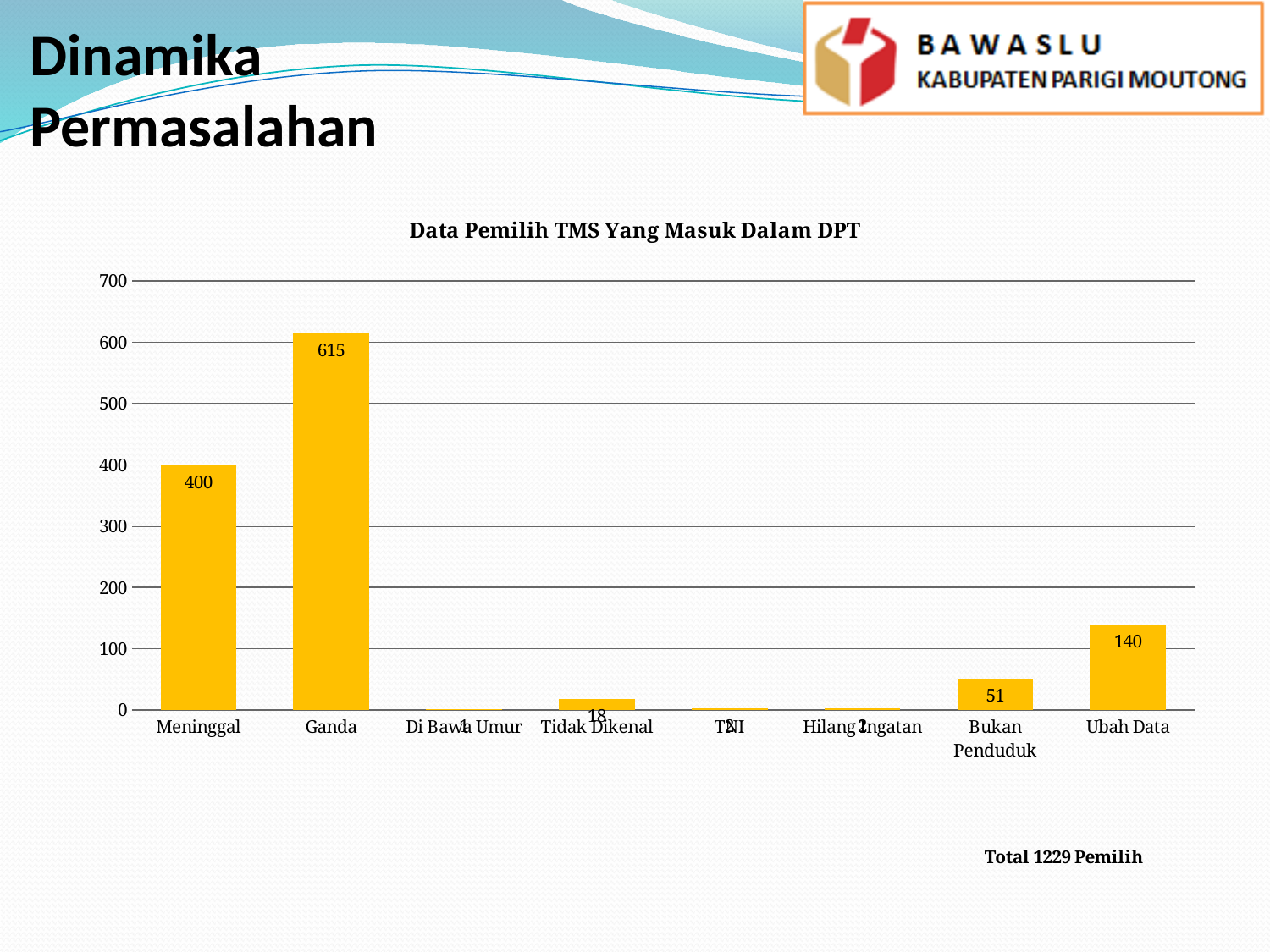
What is the value for Ubah Data in the chart? 140 Is the value for Ubah Data greater or less than 200? less How many categories are shown on the x axis of the chart? 8 Which is larger, the value for Ubah Data or the value for Bukan Penduduk? Ubah Data What is the difference between the values for Ganda and Meninggal? 215 Which category has the highest value in the chart? Ganda What is the value for Meninggal in the chart? 400 What is the title of the chart? Data Pemilih TMS Yang Masuk Dalam DPT What kind of chart is shown on the slide? bar chart What is the value for Tidak Dikenal in the chart? 18 What is the value for Ganda in the chart? 615 What is the value for Bukan Penduduk in the chart? 51